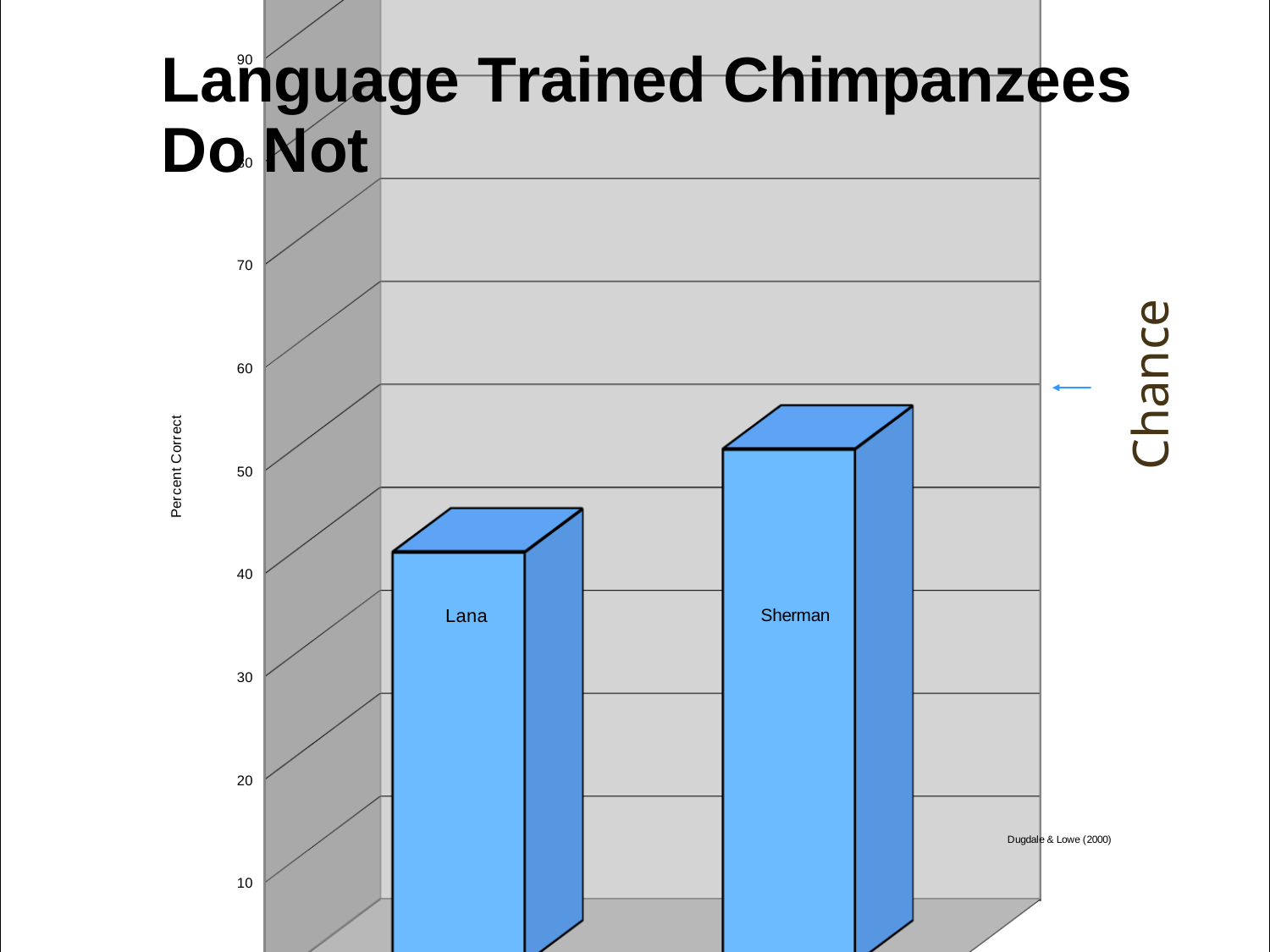
Is the value for Sherman greater or less than 60? less What is the label of the vertical axis? Percent Correct Is the value for Lana greater or less than 50? less Is the value for Lana greater or less than 30? greater What kind of chart is shown on the slide? bar chart What is the highest tick value shown on the vertical axis? 90 How many bars (categories) are plotted in the chart? 2 Which chimpanzee has the higher percent correct, Lana or Sherman? Sherman Which category has the highest value in the chart? Sherman Which category has the lowest value in the chart? Lana